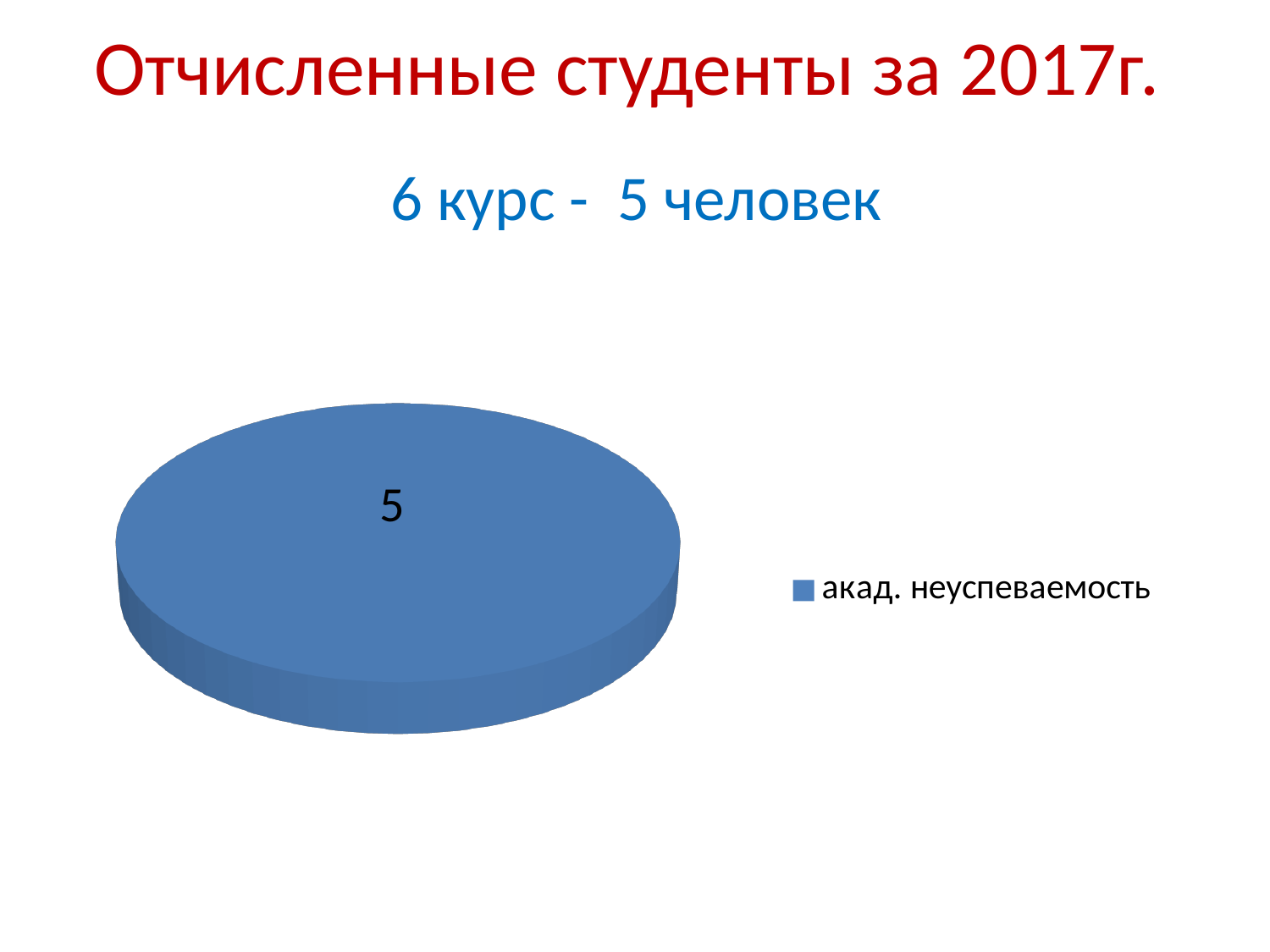
What is the legend entry of the pie chart? акад. неуспеваемость How many slices does the pie chart have? 1 What share of the pie does акад. неуспеваемость represent? 100% What kind of chart is shown on the slide? pie chart Which category has the highest value in the pie chart? акад. неуспеваемость What is the value shown for акад. неуспеваемость? 5 How many entries does the legend list? 1 What colour is the slice for акад. неуспеваемость? blue What is the total of all slices in the pie chart? 5